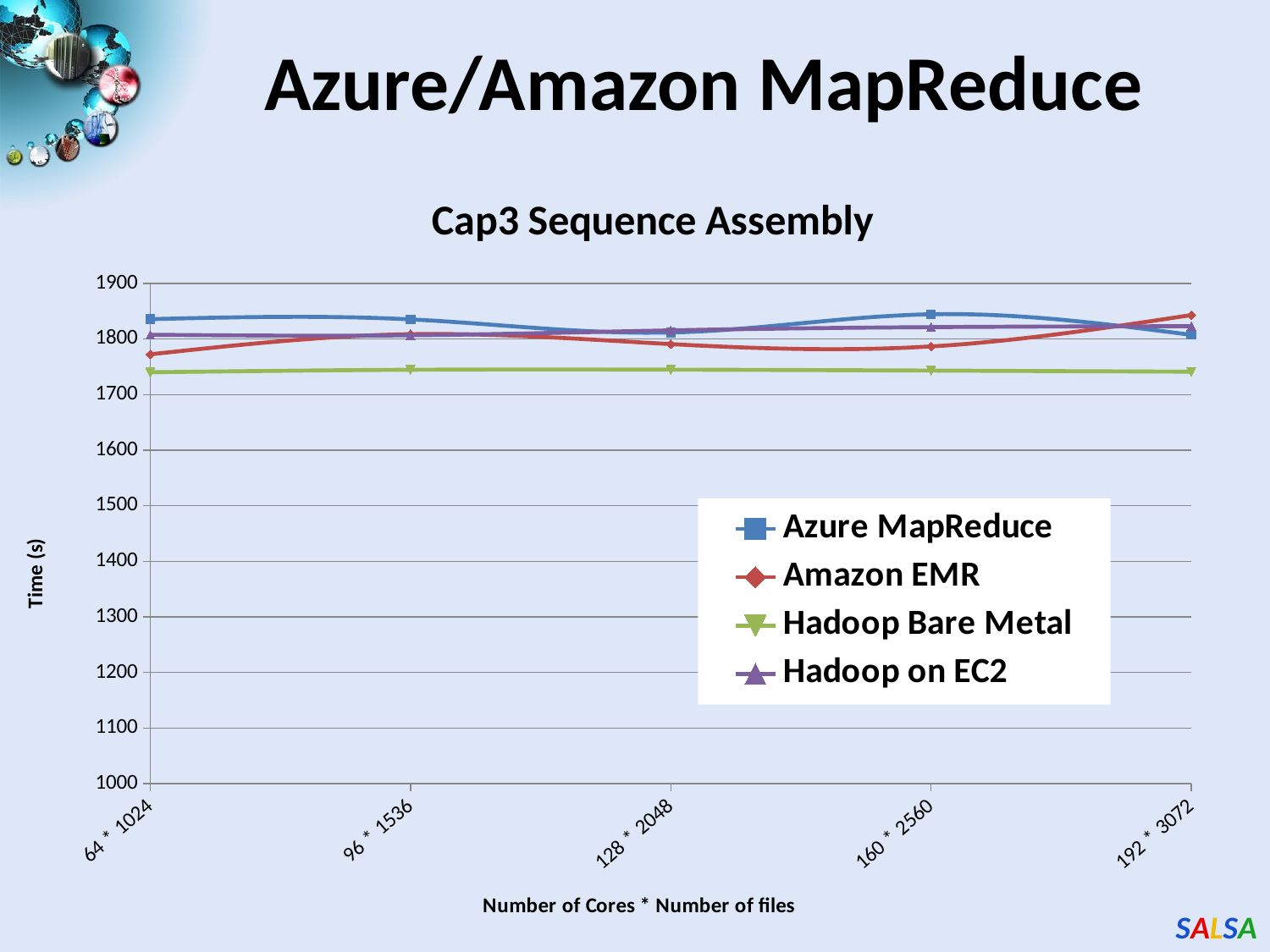
At 192 * 3072, which is larger: Amazon EMR or Azure MapReduce? Amazon EMR Which series has the lowest time at 128 * 2048? Hadoop Bare Metal Is the value for Azure MapReduce at 160 * 2560 greater or less than 1800? greater Is the value for Amazon EMR at 64 * 1024 greater or less than 1800? less At 96 * 1536, which is larger: Azure MapReduce or Hadoop Bare Metal? Azure MapReduce What kind of chart is shown on the slide? line chart Which series has the highest time at 64 * 1024? Azure MapReduce How many series does the legend list? 4 What is the title of the chart? Cap3 Sequence Assembly What is the label of the y axis? Time (s) Is the value for Hadoop Bare Metal at 64 * 1024 greater or less than 1800? less How many categories are shown on the x axis? 5